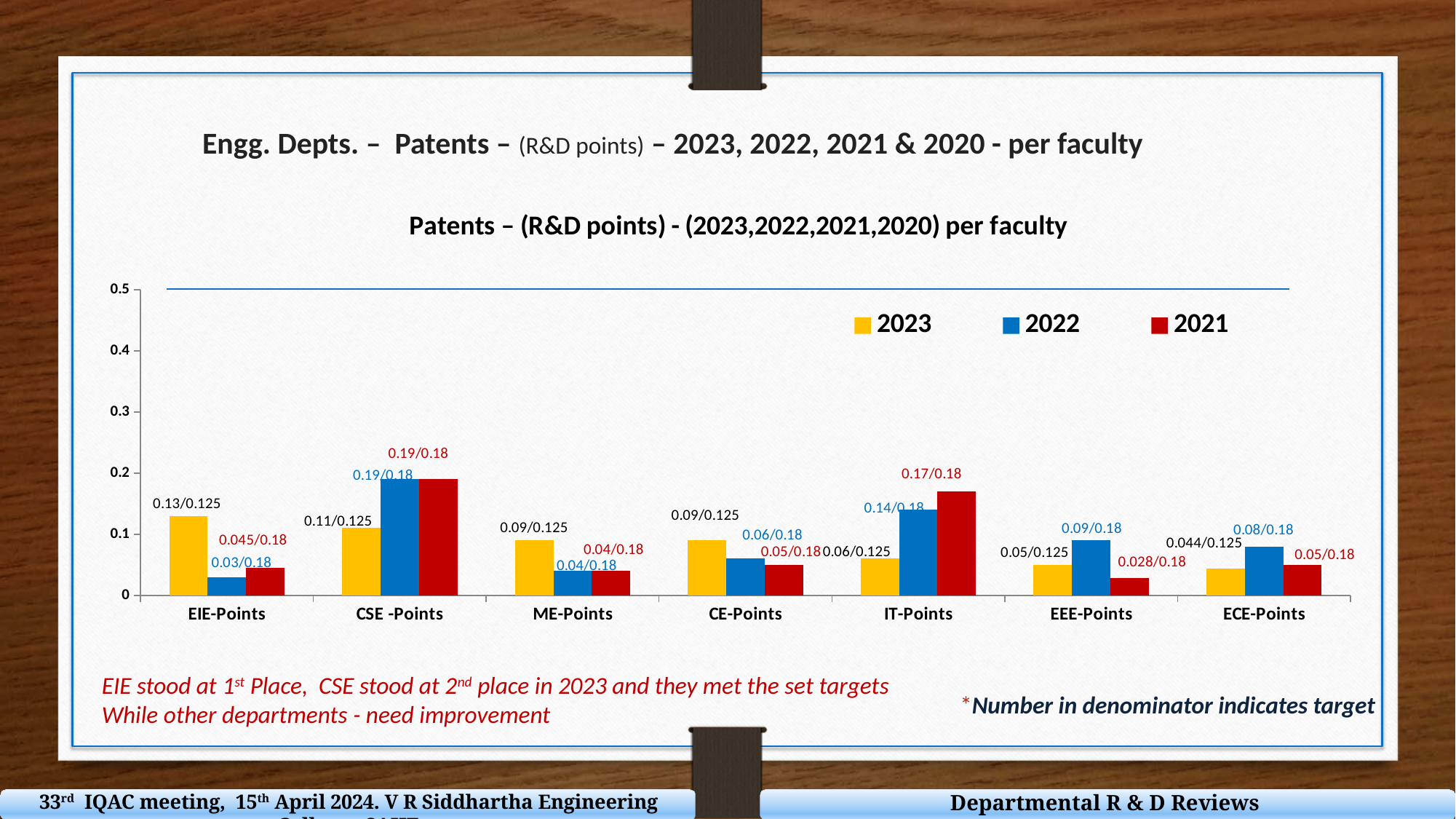
How many departments are shown on the x axis? 7 What is the data label for the 2021 bar for IT-Points? 0.17/0.18 Which department has the highest 2023 value? EIE-Points Is the 2022 value for CSE -Points greater or less than 0.1? greater What kind of chart is shown? bar chart What is the data label for the 2023 bar for EIE-Points? 0.13/0.125 Which is larger, the 2022 value for IT-Points or the 2022 value for EEE-Points? IT-Points Which department has the lowest 2023 value? ECE-Points What is the difference between the 2023 values for EIE-Points (0.13) and CSE -Points (0.11)? 0.02 What is the data label for the 2022 bar for EEE-Points? 0.09/0.18 Which department has the lowest 2021 value? EEE-Points How many series does the legend list? 3